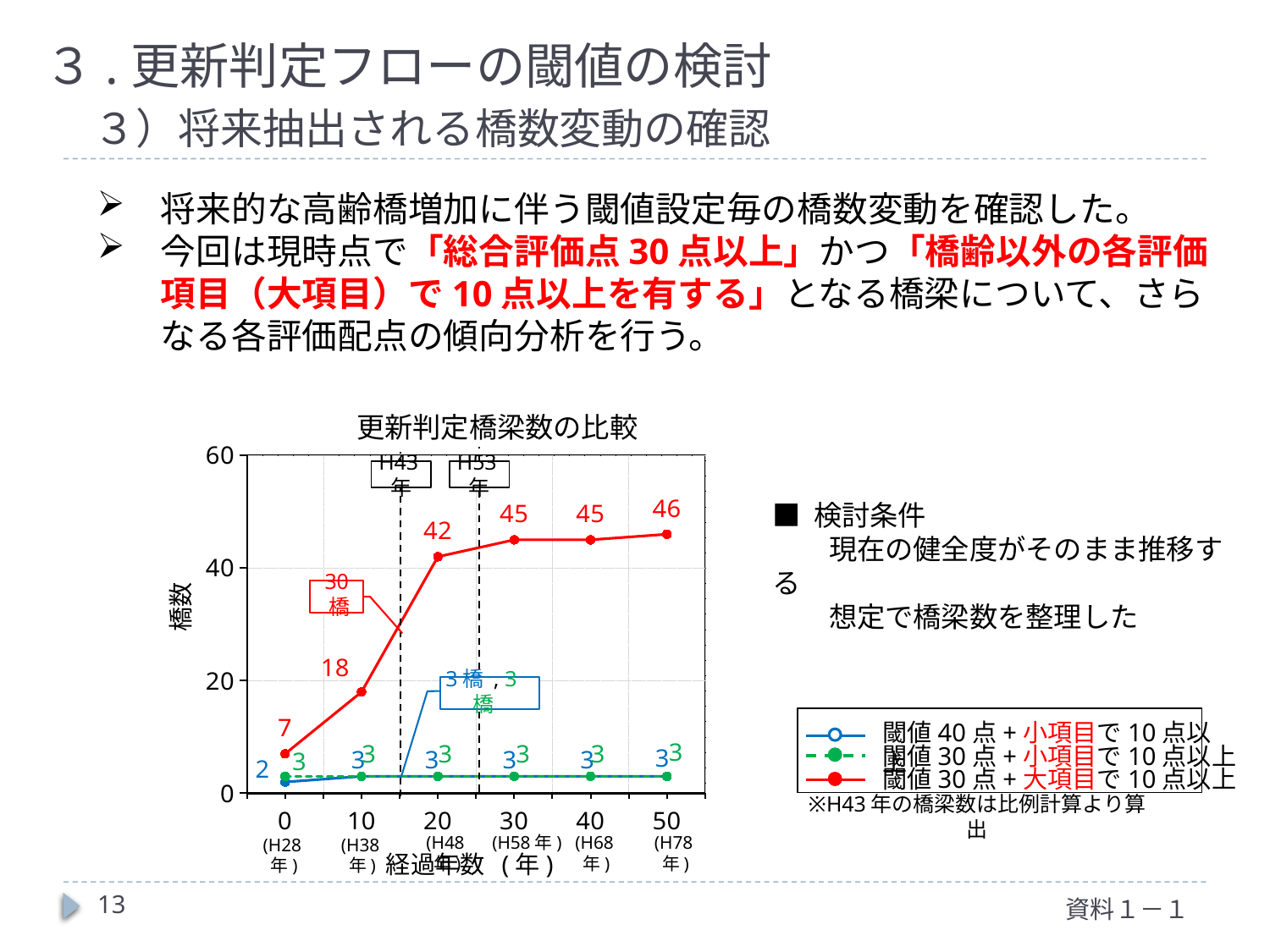
Which series has the larger value at 経過年数 30: 閾値30点+大項目で10点以上 or 閾値30点+小項目で10点以上? 閾値30点+大項目で10点以上 At which 経過年数 is the 閾値30点+大項目で10点以上 series lowest? 0 How many series does the chart legend list? 3 What is the value of the 閾値30点+大項目で10点以上 series at 経過年数 20? 42 At which 経過年数 is the 閾値30点+大項目で10点以上 series highest? 50 What is the difference between the 閾値30点+大項目で10点以上 values at 経過年数 20 and 経過年数 10? 24 Does the 閾値30点+大項目で10点以上 series rise or fall as 経過年数 increases from 0 to 50? rise What is the value of the 閾値30点+大項目で10点以上 series at 経過年数 50? 46 What is the title of the chart? 更新判定橋梁数の比較 What kind of chart is shown on the slide? line chart What is the value of the 閾値40点+小項目で10点以上 series at 経過年数 0? 2 How many points along the x axis (経過年数) are plotted for each series? 6